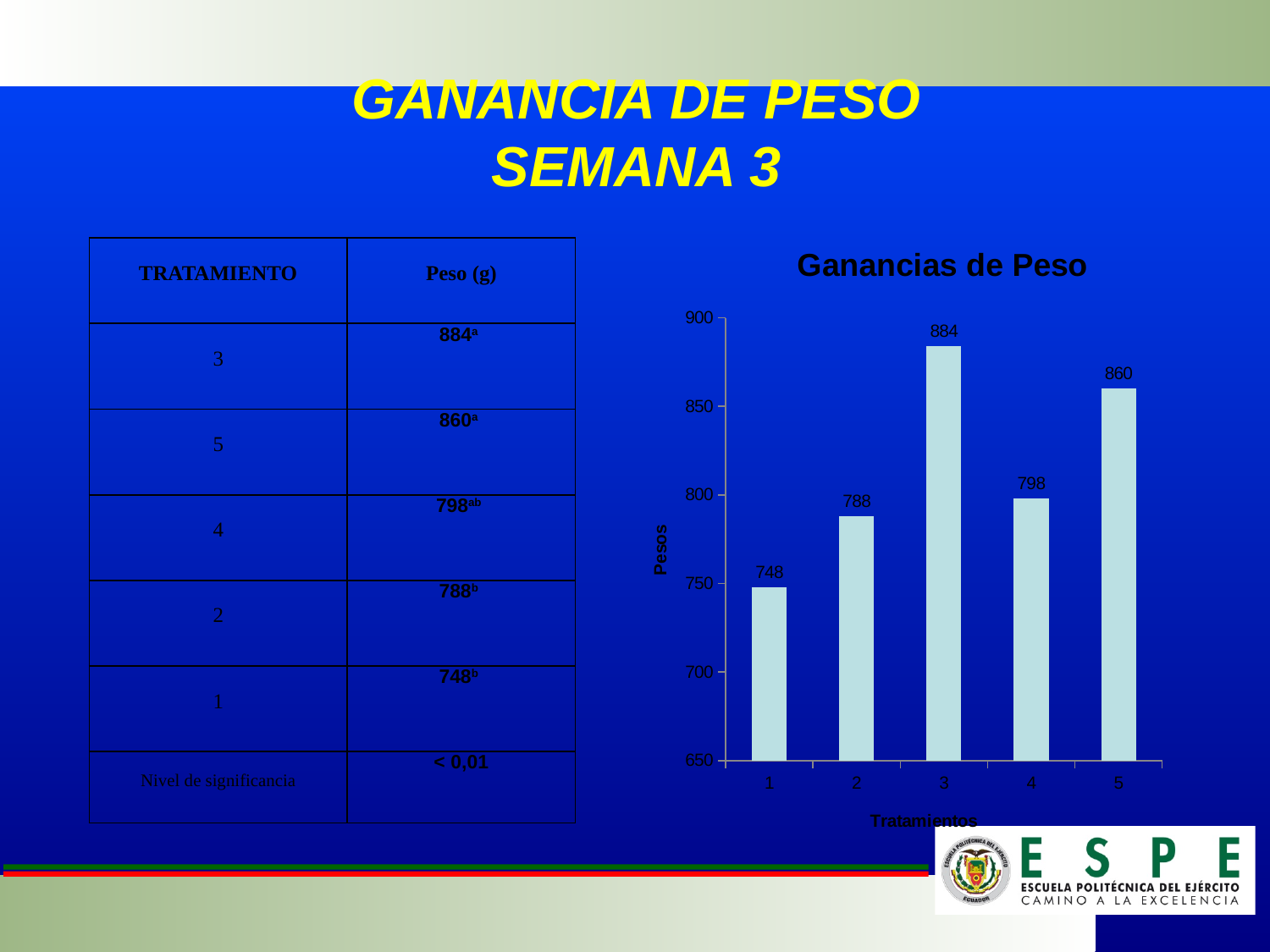
What is the value for Tratamiento 1 in the chart? 748 What is the difference between the values for Tratamiento 5 and Tratamiento 4? 62 Which tratamiento has the lowest value in the chart? 1 What is the value for Tratamiento 3 in the chart? 884 What is the difference between the values for Tratamiento 3 and Tratamiento 1? 136 What is the title of the chart? Ganancias de Peso Which tratamiento has the highest value in the chart? 3 Which is larger, the value for Tratamiento 2 or Tratamiento 4? Tratamiento 4 How many tratamientos are shown on the x axis of the chart? 5 What is the value for Tratamiento 5 in the chart? 860 Is the value for Tratamiento 2 greater or less than 800? less What kind of chart is shown on the slide? bar chart